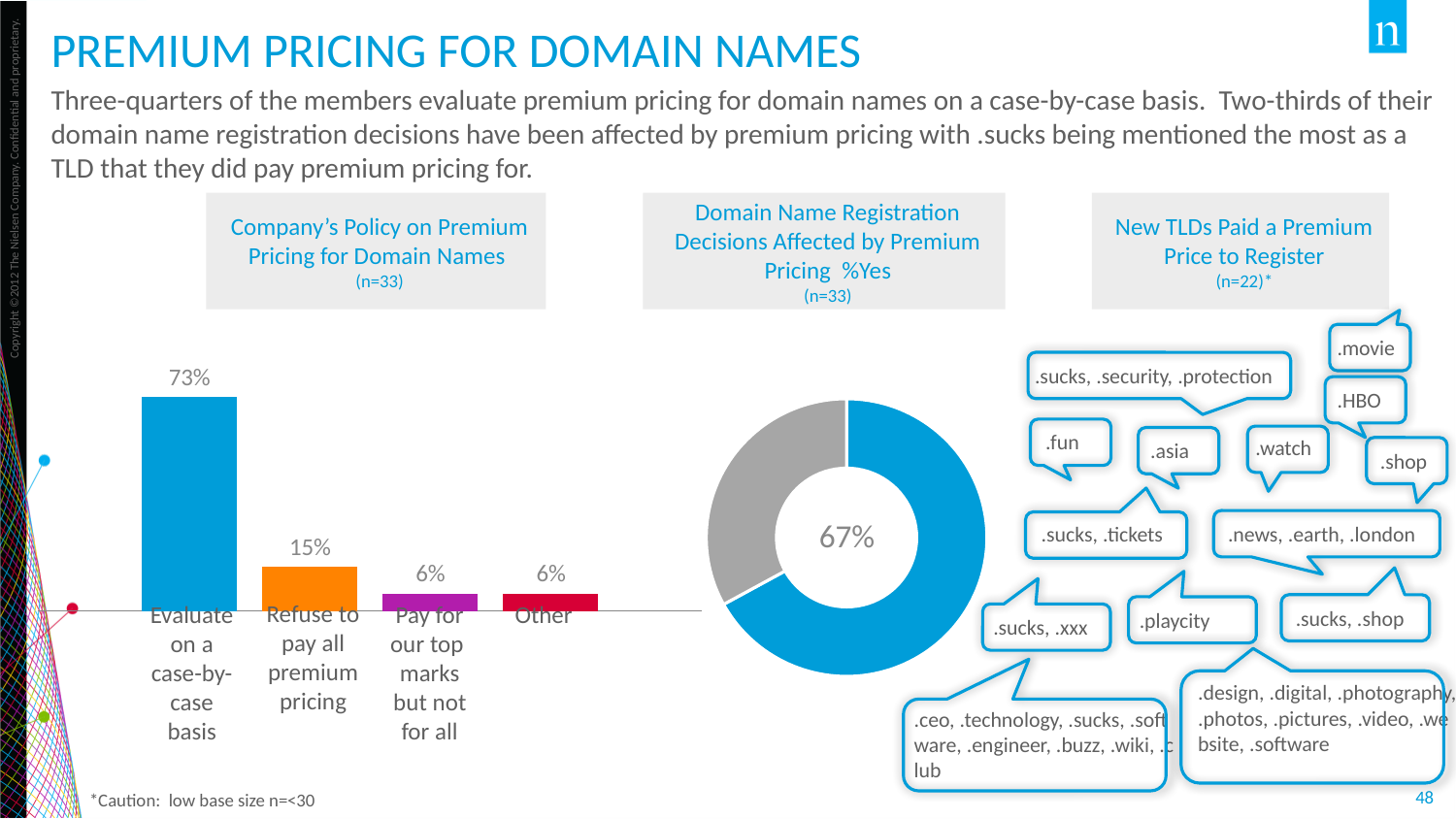
In the 'Domain Name Registration Decisions Affected by Premium Pricing %Yes' chart, what percentage is shown? 67% How many categories are shown in the 'Company's Policy on Premium Pricing for Domain Names' chart? 4 In the 'Company's Policy on Premium Pricing for Domain Names' chart, which category has the highest value? Evaluate on a case-by-case basis In the 'Company's Policy on Premium Pricing for Domain Names' chart, what is the value for 'Pay for our top marks but not for all'? 6% What is the sample size (n) shown for the 'Company's Policy on Premium Pricing for Domain Names' chart? n=33 In the 'Company's Policy on Premium Pricing for Domain Names' chart, which is larger: 'Refuse to pay all premium pricing' or 'Other'? Refuse to pay all premium pricing In the 'Company's Policy on Premium Pricing for Domain Names' chart, what is the value for 'Refuse to pay all premium pricing'? 15% What colour is the bar for 'Refuse to pay all premium pricing' in the 'Company's Policy on Premium Pricing for Domain Names' chart? Orange What type of chart is the 'Domain Name Registration Decisions Affected by Premium Pricing %Yes' chart? Donut chart What type of chart is the 'Company's Policy on Premium Pricing for Domain Names' chart? Bar chart In the 'Company's Policy on Premium Pricing for Domain Names' chart, what percentage of members evaluate on a case-by-case basis? 73% In the 'Company's Policy on Premium Pricing for Domain Names' chart, what is the difference between 'Evaluate on a case-by-case basis' and 'Refuse to pay all premium pricing'? 58%